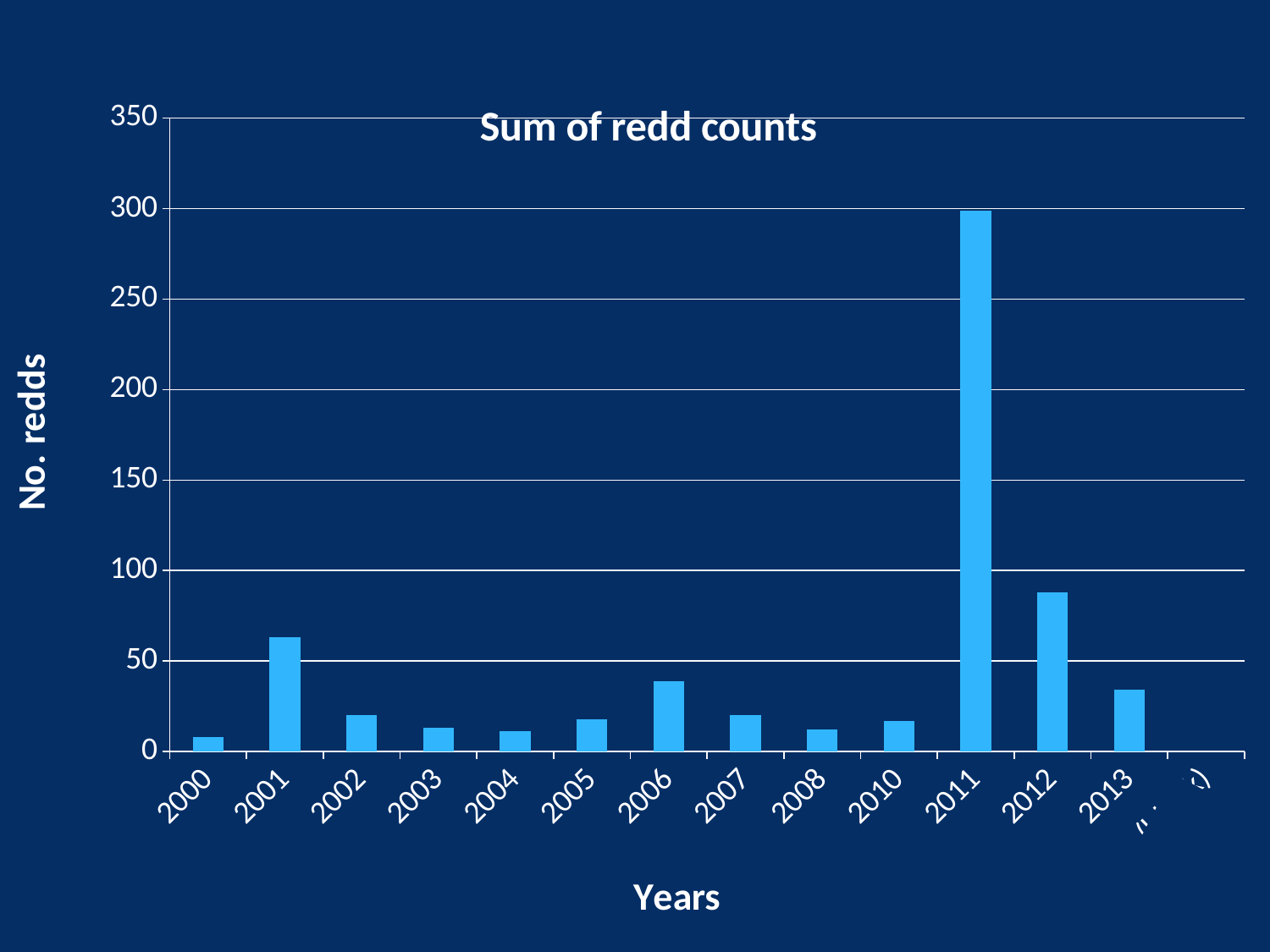
Which year has the larger value, 2012 or 2013? 2012 What kind of chart is shown on the slide? bar chart What is the title of the chart? Sum of redd counts What is the label on the vertical axis of the chart? No. redds Is the value for 2013 greater or less than 50? less Is the value for 2006 greater or less than 50? less Is the value for 2012 greater or less than 100? less Which year has the lowest sum of redd counts? 2000 Which year has the larger value, 2001 or 2006? 2001 Which year has the highest sum of redd counts? 2011